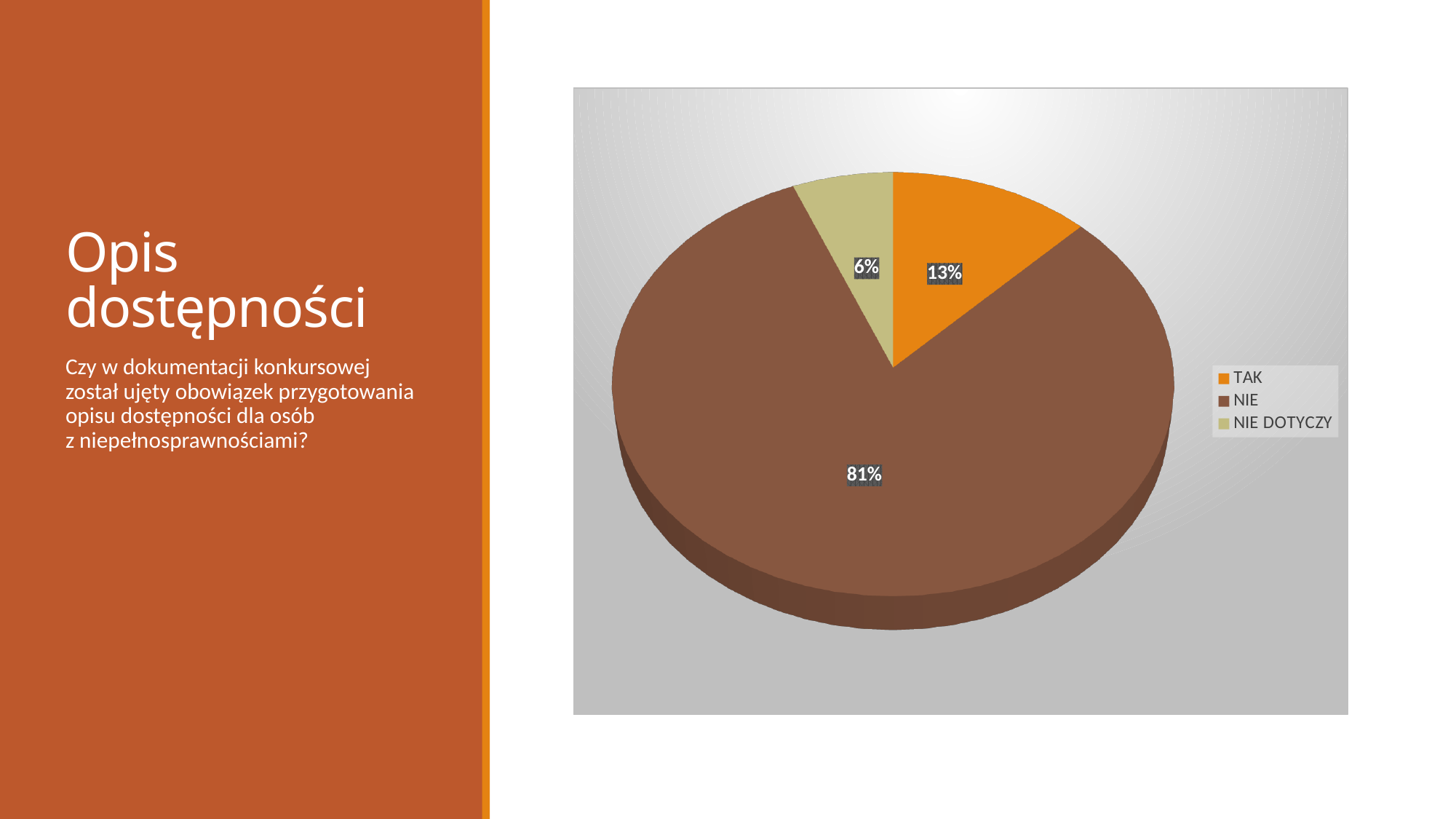
Which category has the smallest slice of the pie? NIE DOTYCZY What percentage of the pie is labelled TAK? 13% How many entries does the legend list? 3 What colour is the NIE DOTYCZY slice in the pie chart? beige What percentage of the pie is labelled NIE? 81% What is the difference in percentage points between the NIE slice and the TAK slice? 68 What percentage of the pie is labelled NIE DOTYCZY? 6% What is the difference in percentage points between the TAK slice and the NIE DOTYCZY slice? 7 How many slices does the pie chart have? 3 What kind of chart is shown on the slide? pie chart Which category has the largest slice of the pie? NIE Which slice is larger, TAK or NIE DOTYCZY? TAK